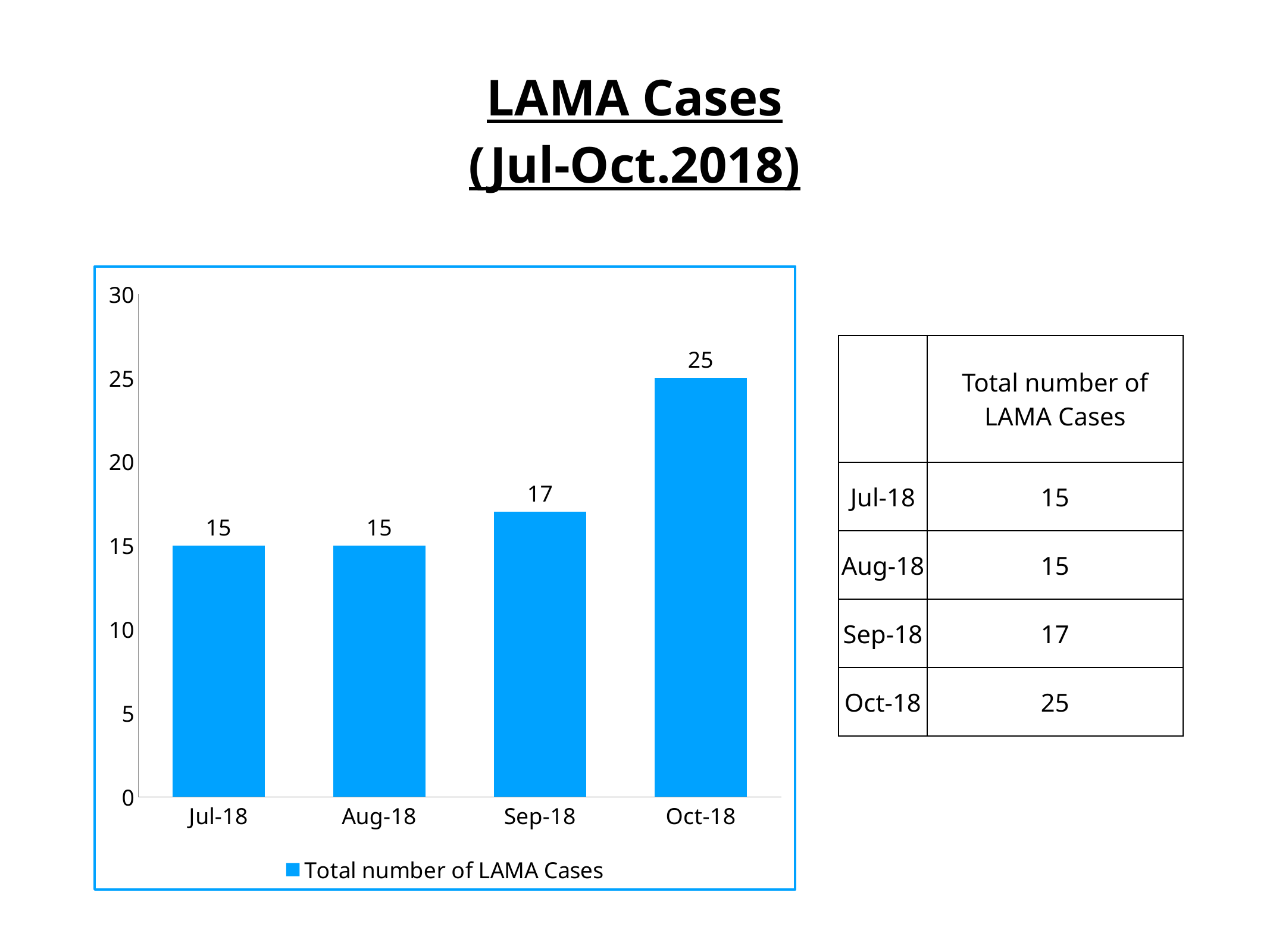
Do the LAMA case values rise or fall from Jul-18 to Oct-18? Rise What is the total number of LAMA cases for Sep-18? 17 What is the total number of LAMA cases for Oct-18? 25 What is the difference in LAMA cases between Sep-18 and Aug-18? 2 What is the total number of LAMA cases for Jul-18? 15 How many series does the chart legend list? 1 How many months are shown on the x axis of the chart? 4 Which has more LAMA cases, Sep-18 or Oct-18? Oct-18 What is the difference in LAMA cases between Oct-18 and Sep-18? 8 Which month has the highest number of LAMA cases? Oct-18 What kind of chart is shown on the slide? Bar chart Is the value for Oct-18 greater or less than 20? greater